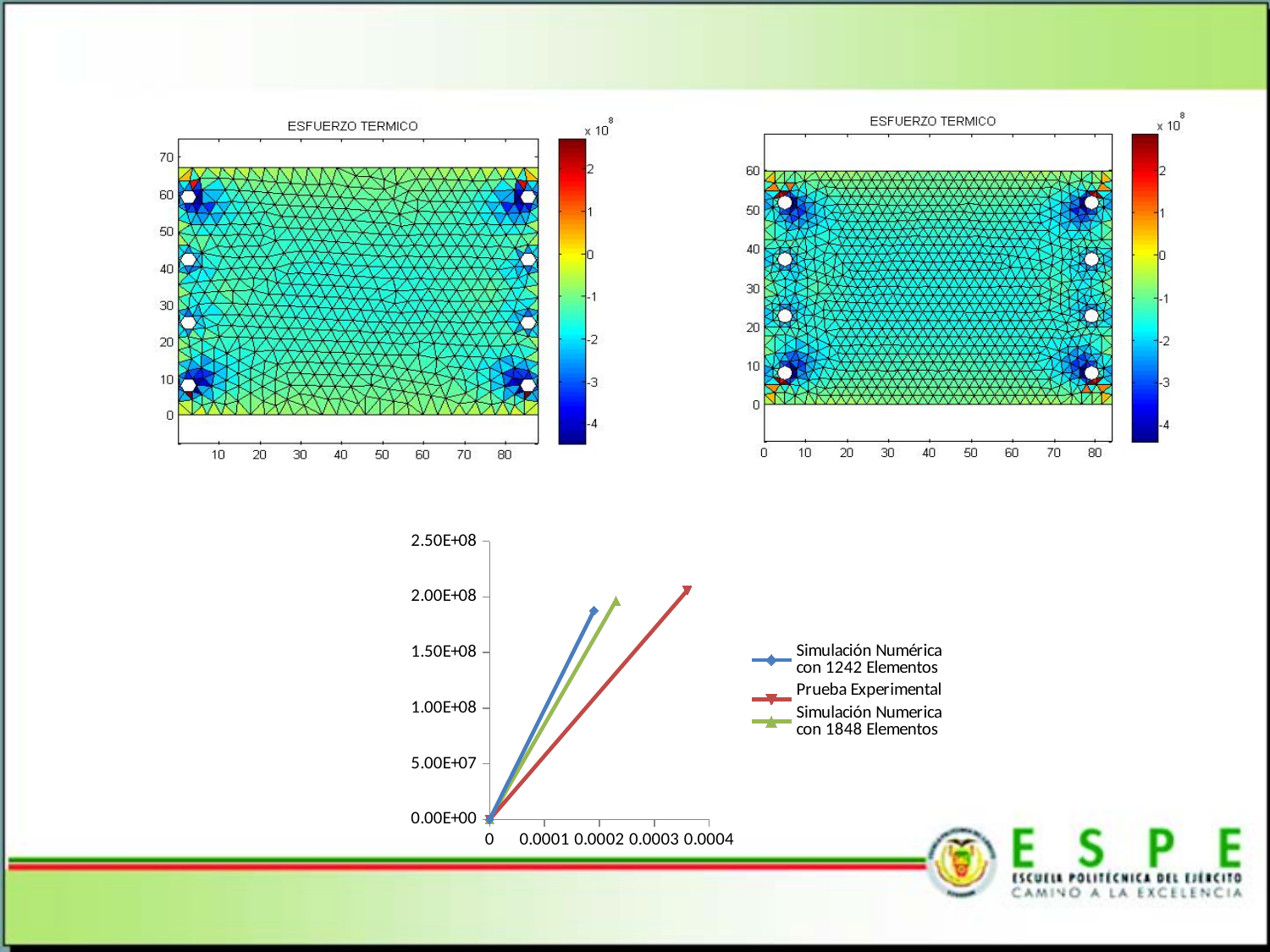
In the bottom line chart, is the highest value reached by Prueba Experimental greater or less than 1.50E+08? greater In the bottom line chart, which series reaches the highest value on the y axis? Prueba Experimental In the bottom line chart, is the highest value reached by Simulación Numérica con 1242 Elementos greater or less than 2.00E+08? less In the bottom line chart, which series extends furthest along the x axis? Prueba Experimental How many series does the legend of the bottom line chart list? 3 In the bottom line chart, what is the highest value shown on the y axis? 2.50E+08 In the bottom line chart, do the values of the series rise or fall as the x axis increases? rise In the bottom line chart, which series ends at a larger x value: Simulación Numérica con 1242 Elementos or Prueba Experimental? Prueba Experimental In the bottom line chart, is the x value at the end of the Prueba Experimental line greater or less than 0.0003? greater What kind of chart is the chart at the bottom of the slide? line chart What is the title of the two mesh plots at the top of the slide? ESFUERZO TERMICO